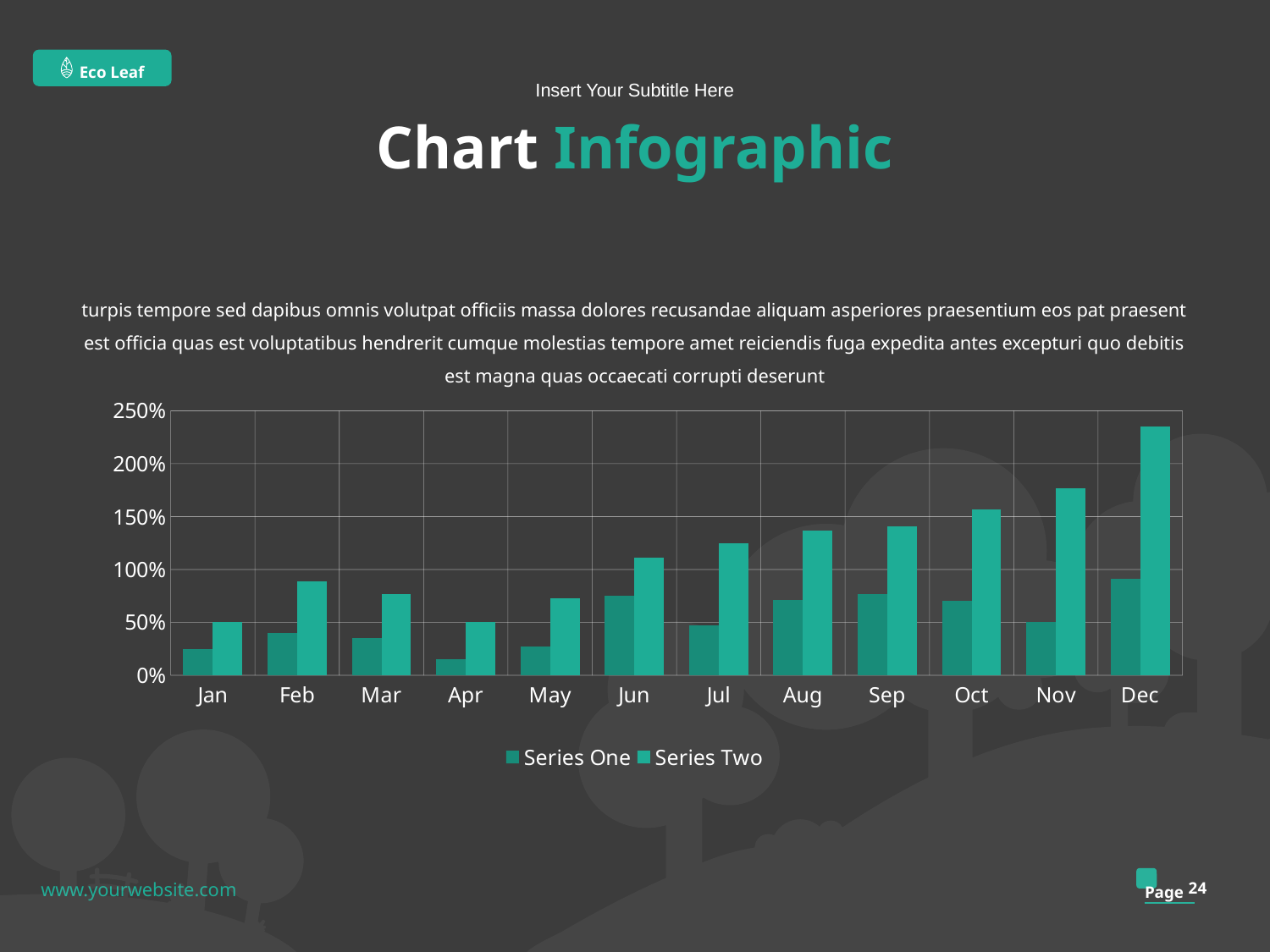
Is the Series One value for Jun greater or less than 50%? greater How many series does the legend list? 2 Is the Series Two value for Oct greater or less than 150%? greater Is the Series Two value for Jan greater or less than 100%? less How many months are shown on the x axis of the chart? 12 Which is larger for Series Two: Nov or Oct? Nov What are the names of the two series in the legend? Series One and Series Two What kind of chart is shown on the slide? bar chart Does Series Two generally rise or fall from Jan to Dec? rise Which month has the highest value for Series Two? Dec Which month has the lowest value for Series One? Apr